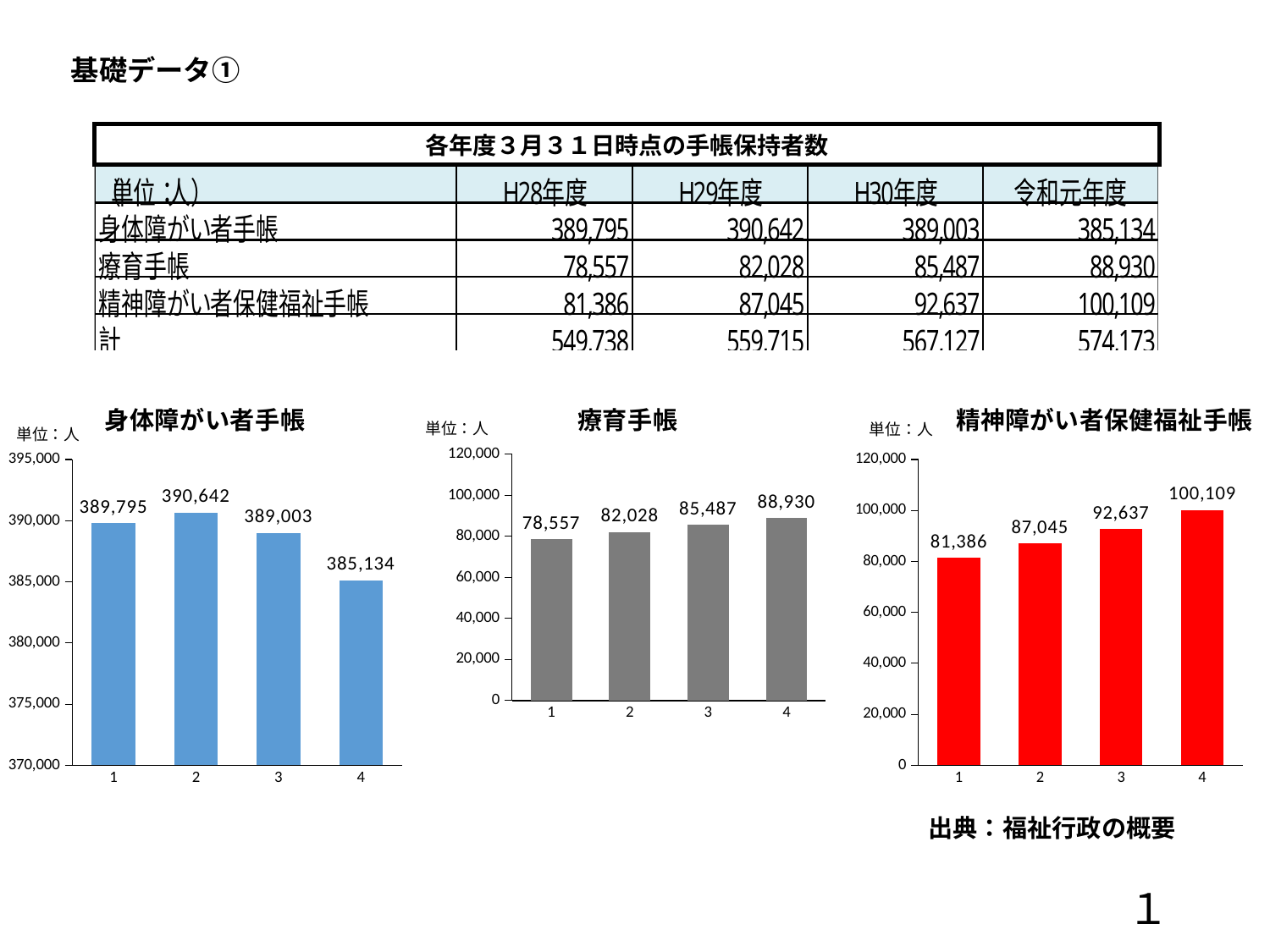
In the 療育手帳 chart, what is the value for category 1? 78,557 In the 身体障がい者手帳 chart, what is the difference between the values for category 2 and category 4? 5,508 In the 精神障がい者保健福祉手帳 chart, what is the difference between the values for category 4 and category 1? 18,723 How many bars does the 身体障がい者手帳 chart have? 4 Which is larger: the value for category 3 in the 療育手帳 chart or the value for category 3 in the 精神障がい者保健福祉手帳 chart? 精神障がい者保健福祉手帳 (92,637) In the 療育手帳 chart, do the values rise or fall from category 1 to category 4? rise In the 精神障がい者保健福祉手帳 chart, what is the value for category 4? 100,109 In the 療育手帳 chart, is the value for category 4 greater or less than 100,000? less In the 精神障がい者保健福祉手帳 chart, which category has the highest value? 4 What type of chart is the 精神障がい者保健福祉手帳 chart? bar chart In the 身体障がい者手帳 chart, what is the value for category 2? 390,642 In the 身体障がい者手帳 chart, which category has the lowest value? 4